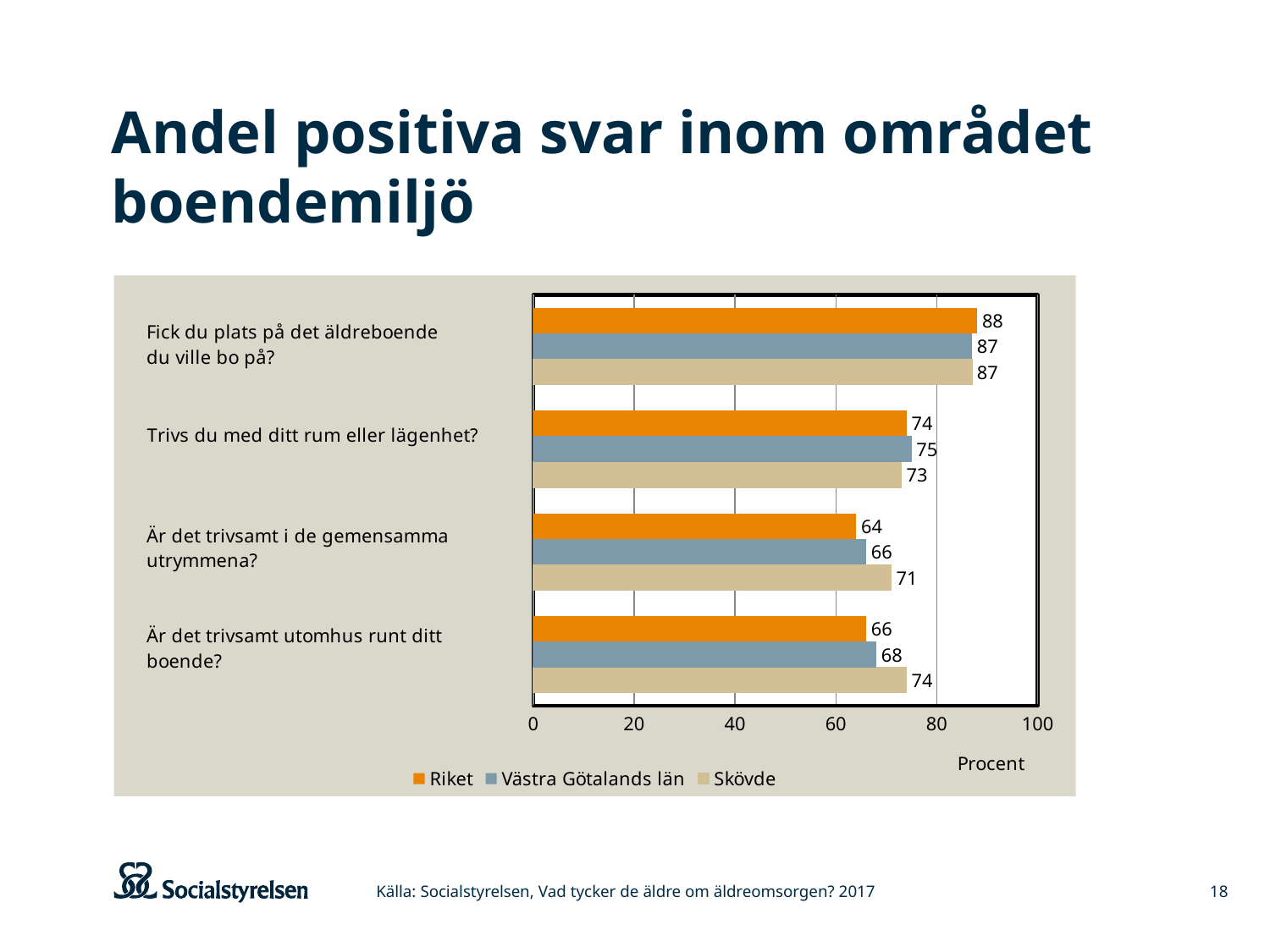
What kind of chart is shown on the slide? Bar chart What is the value for Riket for "Fick du plats på det äldreboende du ville bo på?"? 88 How many series does the legend list? 3 How many question categories are shown on the chart? 4 Which category has the highest value for Skövde? Fick du plats på det äldreboende du ville bo på? What is the label on the horizontal axis of the chart? Procent For "Är det trivsamt i de gemensamma utrymmena?", which is larger: the value for Skövde or the value for Riket? Skövde What is the value for Västra Götalands län for "Trivs du med ditt rum eller lägenhet?"? 75 Which category has the lowest value for Riket? Är det trivsamt i de gemensamma utrymmena? What is the value for Skövde for "Är det trivsamt utomhus runt ditt boende?"? 74 What is the value for Skövde for "Är det trivsamt i de gemensamma utrymmena?"? 71 What is the difference between the Skövde value and the Riket value for "Är det trivsamt utomhus runt ditt boende?"? 8